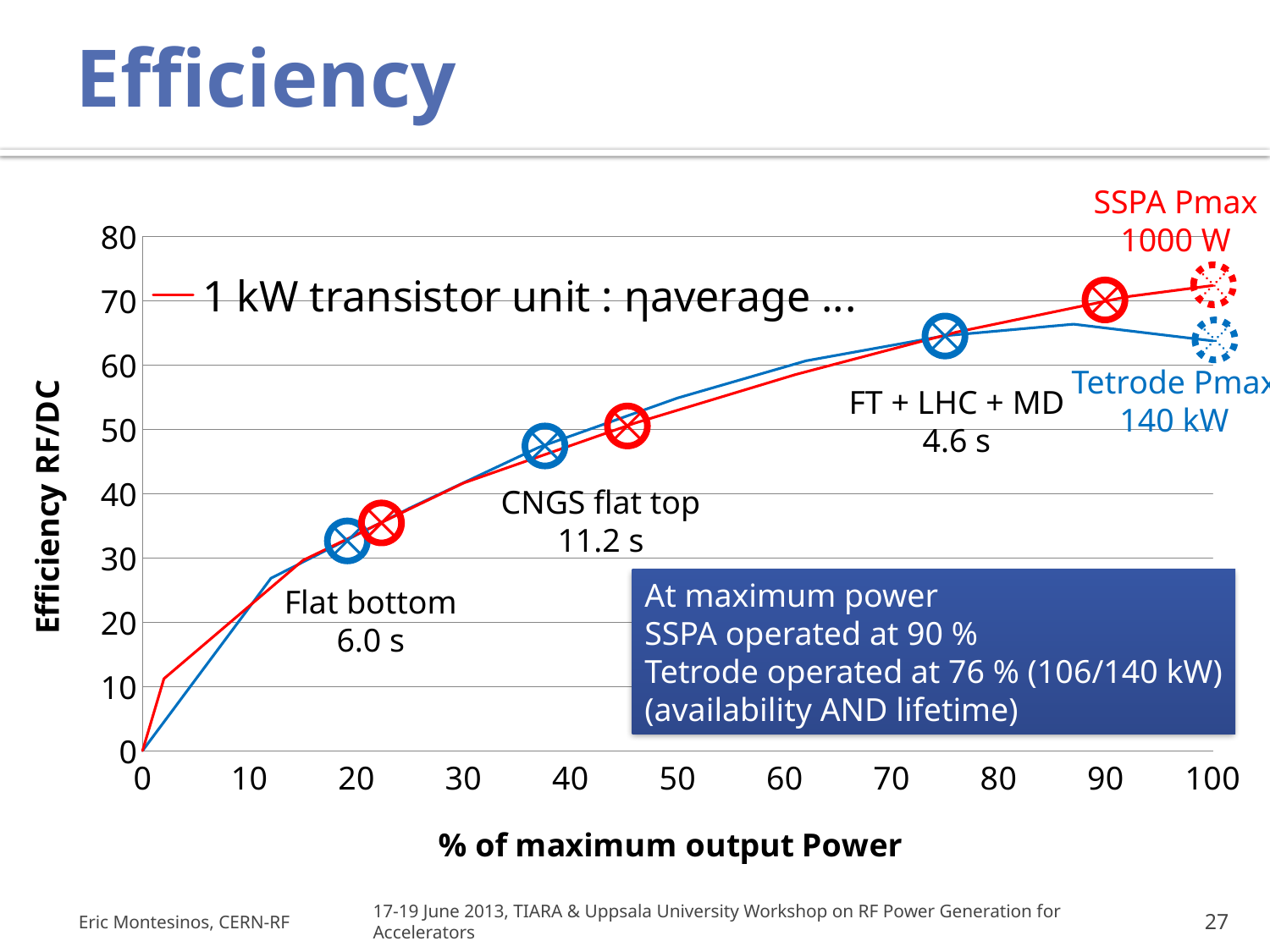
What is the highest value shown on the vertical axis of the chart? 80 How many labelled operating points (Flat bottom, CNGS flat top, FT + LHC + MD) are marked on the chart? 3 What is the title of the vertical axis of the chart? Efficiency RF/DC What kind of chart is shown on the slide? line chart What is the title of the horizontal axis of the chart? % of maximum output Power At 100 % of maximum output Power, is the efficiency of the blue (tetrode) line greater or less than 70? less At 100 % of maximum output Power, which line shows the higher efficiency, the red (1 kW transistor unit) line or the blue (tetrode) line? red (1 kW transistor unit) At 20 % of maximum output Power, is the efficiency of the red (1 kW transistor unit) line greater or less than 40? less At 100 % of maximum output Power, is the efficiency of the red (1 kW transistor unit) line greater or less than 60? greater Does the red line (1 kW transistor unit) rise or fall as % of maximum output Power increases from 0 to 100? rise